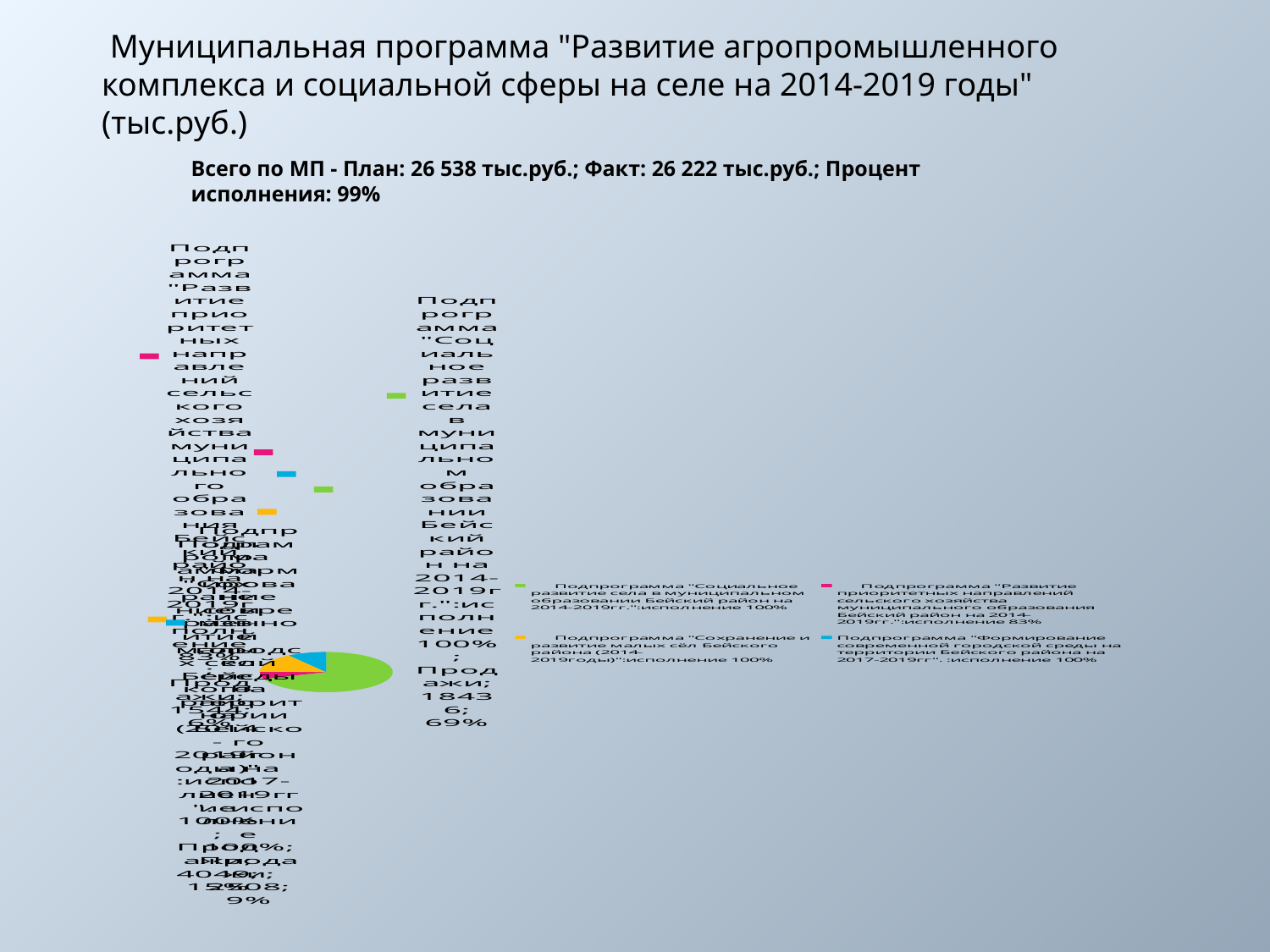
Which subprogram has the largest slice of the pie? Подпрограмма "Социальное развитие села в муниципальном образовании Бейский район на 2014-2019гг." According to the legend, what execution percentage is given for Подпрограмма "Развитие приоритетных направлений сельского хозяйства муниципального образования Бейский район на 2014-2019гг."? 83% What colour is the slice for Подпрограмма "Социальное развитие села в муниципальном образовании Бейский район на 2014-2019гг."? green What value is printed on the slice for Подпрограмма "Социальное развитие села в муниципальном образовании Бейский район на 2014-2019гг."? 18436 What share of the pie does the slice for Подпрограмма "Социальное развитие села в муниципальном образовании Бейский район на 2014-2019гг." represent? 69% How many entries does the chart legend list? 4 Is the share of the green slice (Социальное развитие села) greater or less than 50%? greater What kind of chart is shown on the slide? pie chart